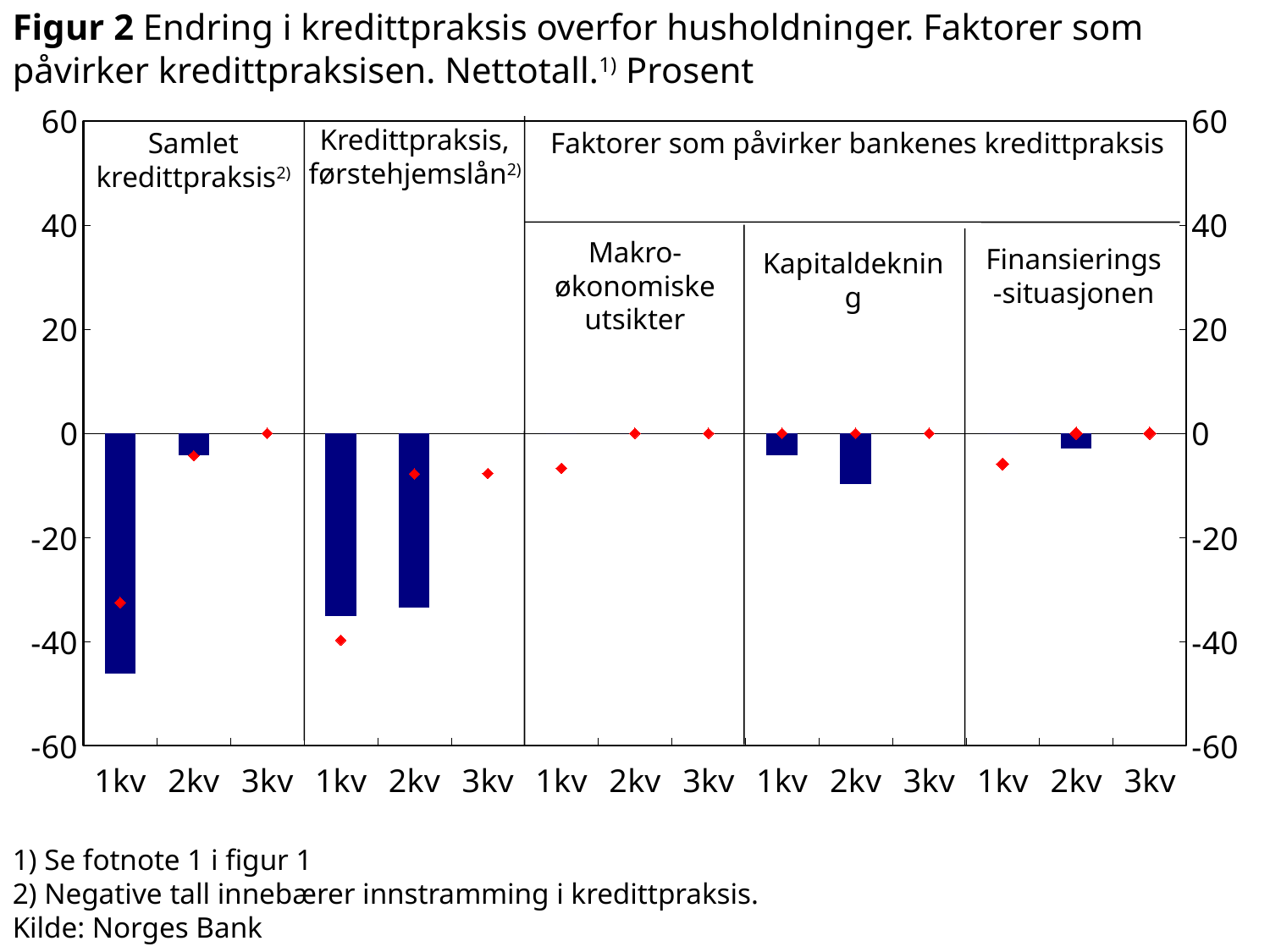
Is the bar for 1kv under 'Samlet kredittpraksis' greater or less than -40? less Is the bar for 1kv under 'Kredittpraksis, førstehjemslån' greater or less than -40? greater Is the bar for 2kv under 'Kapitaldekning' greater or less than -20? greater How many quarters (1kv, 2kv, 3kv) are shown in each panel of the chart? 3 What kind of chart is shown in Figur 2? bar chart with red diamond markers (combination bar and point chart) Which is lower: the 1kv bar or the 2kv bar under 'Kapitaldekning'? 2kv Which is lower: the 1kv bar under 'Samlet kredittpraksis' or the 1kv bar under 'Kredittpraksis, førstehjemslån'? 1kv under Samlet kredittpraksis Do the bars under 'Samlet kredittpraksis' rise or fall from 1kv to 3kv? rise What are the three factors listed under 'Faktorer som påvirker bankenes kredittpraksis'? Makroøkonomiske utsikter, Kapitaldekning, Finansieringssituasjonen Which bar in the whole chart has the lowest (most negative) value? 1kv under Samlet kredittpraksis What is the maximum value shown on the vertical axis? 60